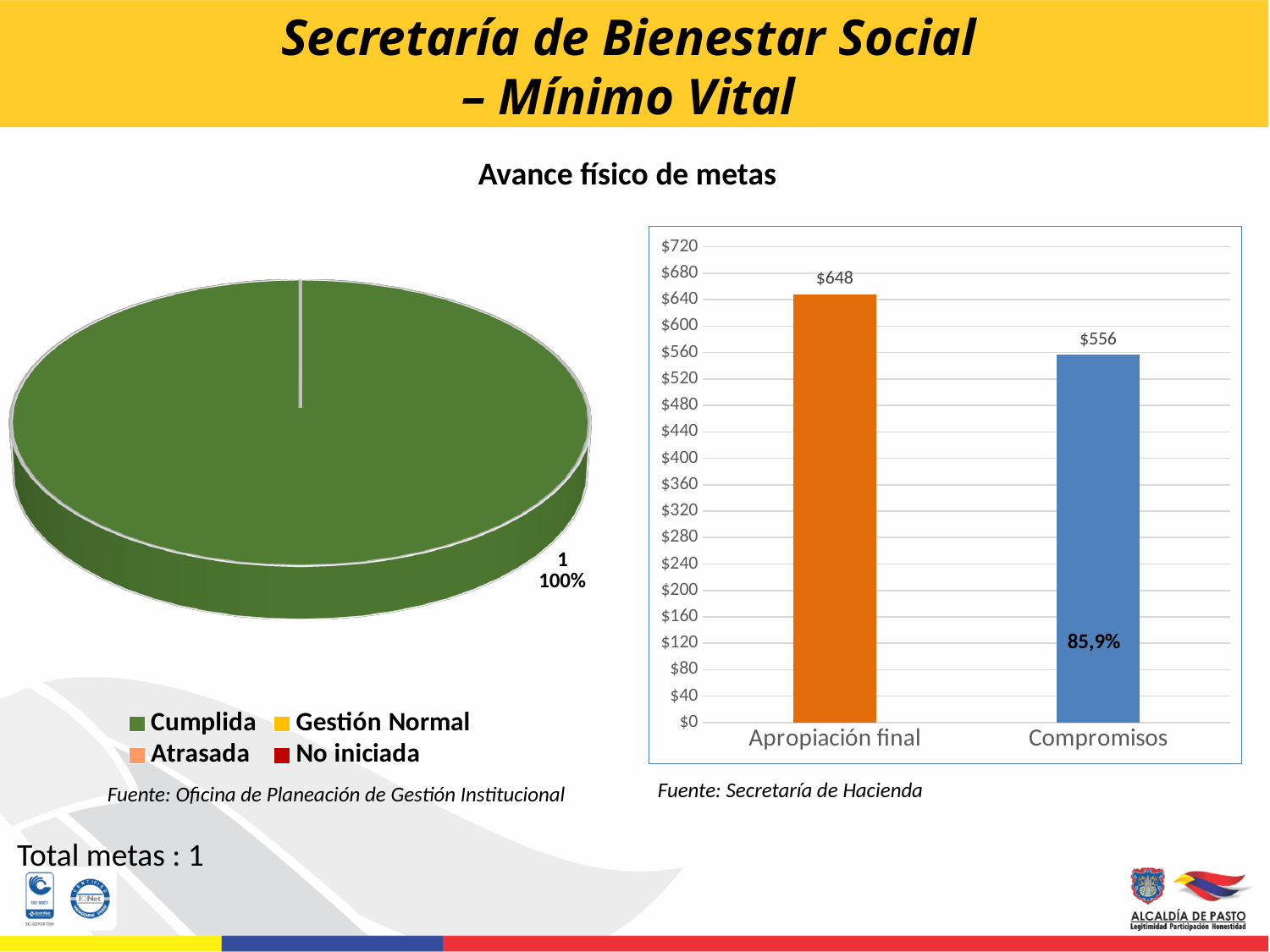
In the bar chart on the right, is the value for Compromisos greater or less than $600? less In the pie chart 'Avance físico de metas', what share does the Cumplida slice represent? 100% In the bar chart on the right, how many categories are shown on the x axis? 2 In the bar chart on the right, what is the value for Compromisos? $556 In the bar chart on the right, which category has the higher value? Apropiación final What kind of chart is shown on the left side of the slide? pie chart In the bar chart on the right, what is the value for Apropiación final? $648 In the bar chart on the right, which category has the lower value? Compromisos In the bar chart on the right, what percentage label is printed on the Compromisos bar? 85,9% How many entries does the legend of the pie chart 'Avance físico de metas' list? 4 In the bar chart on the right, what is the difference between Apropiación final and Compromisos? $92 What kind of chart is shown on the right side of the slide? bar chart